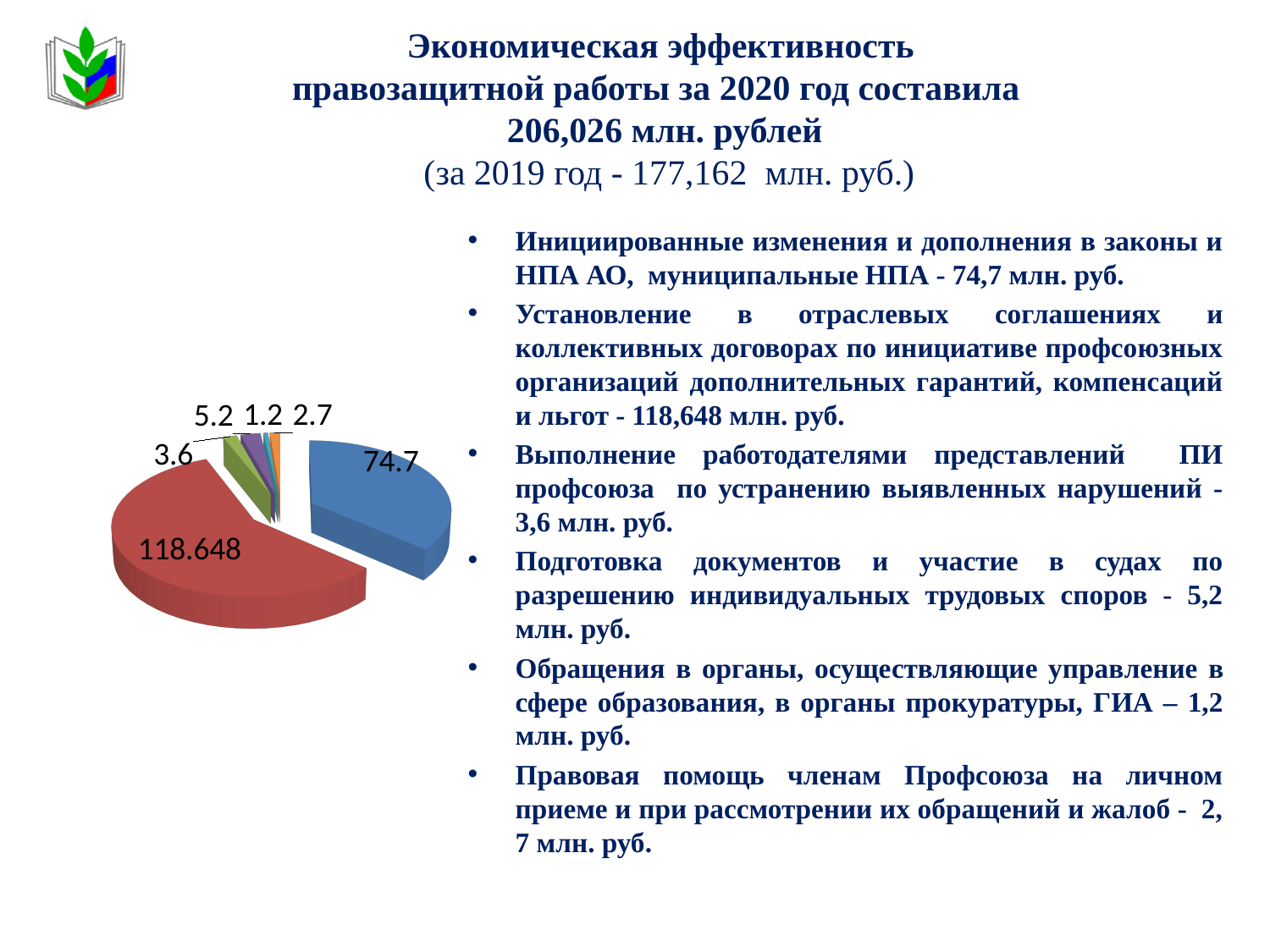
How many slices does the pie chart have? 6 What colour is the largest slice of the pie chart? red Which slice is larger, the blue one labelled 74.7 or the red one labelled 118.648? the red one (118.648) What value is labelled on the blue slice of the pie chart? 74.7 What is the smallest value labelled on the pie chart? 1.2 What is the largest value labelled on the pie chart? 118.648 What is the difference between the slices labelled 5.2 and 3.6? 1.6 What value is labelled on the red slice of the pie chart? 118.648 What kind of chart is shown on the slide? pie chart What is the difference between the two largest values on the pie chart, 118.648 and 74.7? 43.948 Which is larger, the slice labelled 2.7 or the slice labelled 1.2? 2.7 What value is labelled on the green slice of the pie chart? 3.6